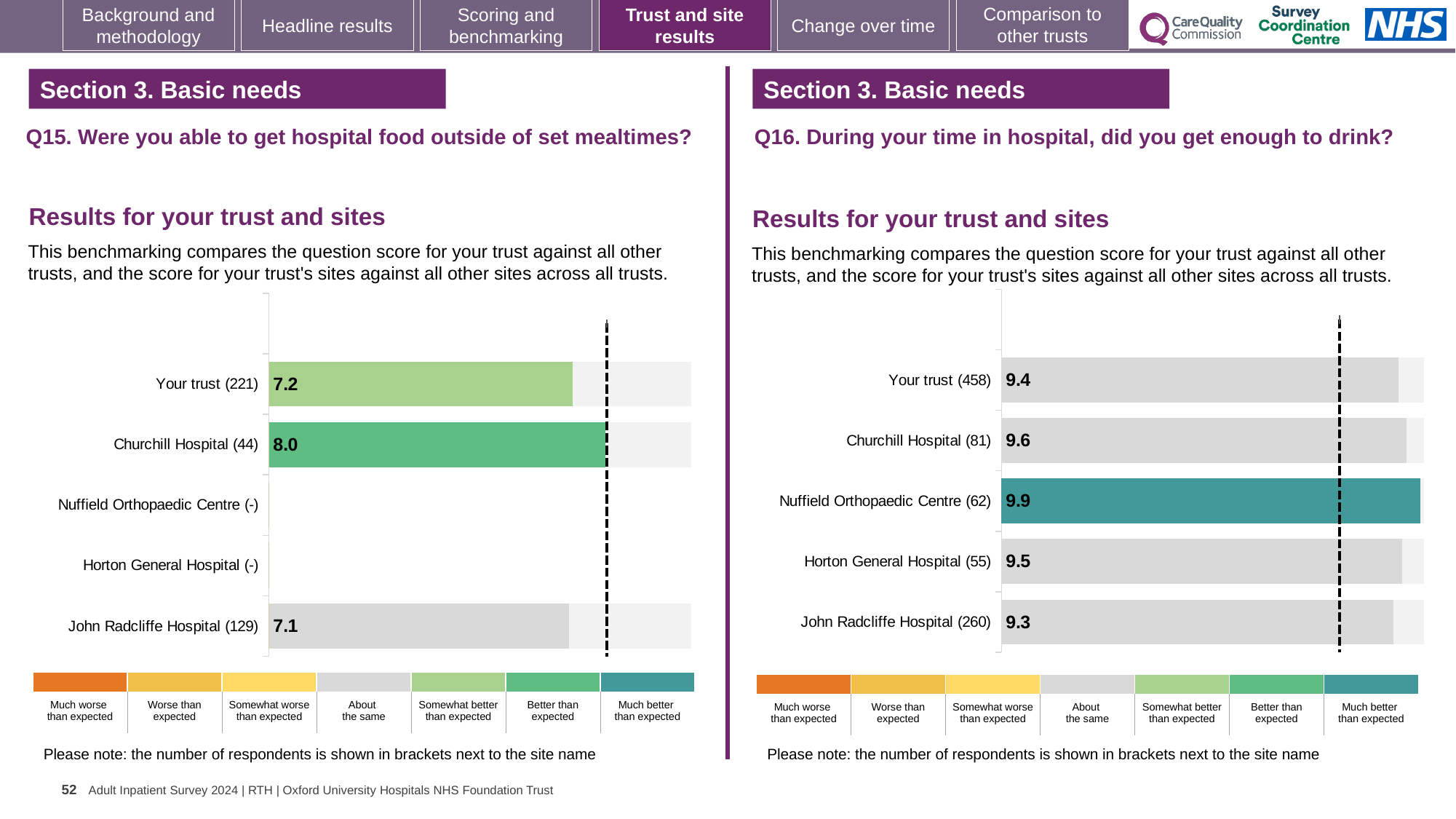
In the Q16 chart on the right, what is the score for Nuffield Orthopaedic Centre (62)? 9.9 In the Q15 chart on the left, what is the score for Your trust (221)? 7.2 In the Q16 chart on the right, what is the score for John Radcliffe Hospital (260)? 9.3 What type of chart is used for the Q15 results on the left? Bar chart In the Q15 chart on the left, which site has the highest score? Churchill Hospital (44) In the Q15 chart on the left, what is the score for Churchill Hospital (44)? 8.0 In the Q15 chart on the left, what is the difference between the scores for Churchill Hospital and John Radcliffe Hospital? 0.9 In the Q16 chart on the right, which benchmark category does the colour of the Nuffield Orthopaedic Centre bar correspond to? Much better than expected In the Q16 chart on the right, how many bars are plotted? 5 In the Q16 chart on the right, which is larger: the score for Churchill Hospital or the score for Horton General Hospital? Churchill Hospital In the Q16 chart on the right, what is the difference between the scores for Nuffield Orthopaedic Centre and Your trust? 0.5 In the Q16 chart on the right, which site has the lowest score? John Radcliffe Hospital (260)